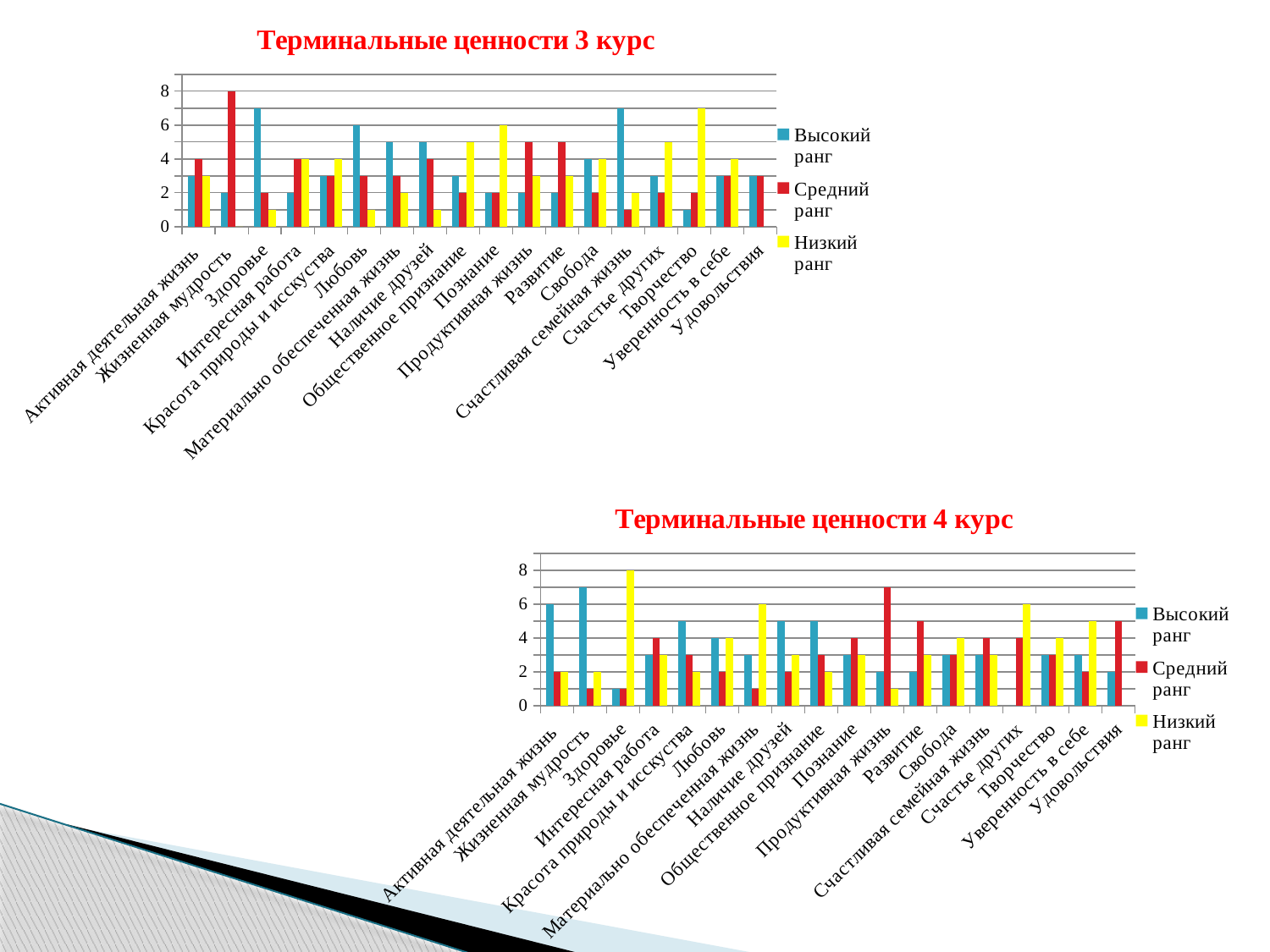
In the 'Терминальные ценности 4 курс' chart, what is the 'Низкий ранг' value for 'Здоровье'? 8 What colour are the 'Низкий ранг' bars in the 'Терминальные ценности 4 курс' chart? yellow How many series does the legend of the 'Терминальные ценности 4 курс' chart list? 3 How many categories are shown on the x axis of the 'Терминальные ценности 3 курс' chart? 18 In the 'Терминальные ценности 3 курс' chart, what is the 'Средний ранг' value for 'Жизненная мудрость'? 8 In the 'Терминальные ценности 4 курс' chart, is the 'Средний ранг' value for 'Продуктивная жизнь' greater or less than 6? greater In the 'Терминальные ценности 4 курс' chart, which category has the highest value for 'Низкий ранг'? Здоровье In the 'Терминальные ценности 3 курс' chart, which is larger for 'Творчество': 'Высокий ранг' or 'Низкий ранг'? Низкий ранг In the 'Терминальные ценности 4 курс' chart, what is the 'Высокий ранг' value for 'Активная деятельная жизнь'? 6 What kind of chart is the 'Терминальные ценности 3 курс' chart? bar chart In the 'Терминальные ценности 3 курс' chart, is the 'Высокий ранг' value for 'Здоровье' greater or less than 6? greater In the 'Терминальные ценности 3 курс' chart, which category has the highest value for 'Средний ранг'? Жизненная мудрость